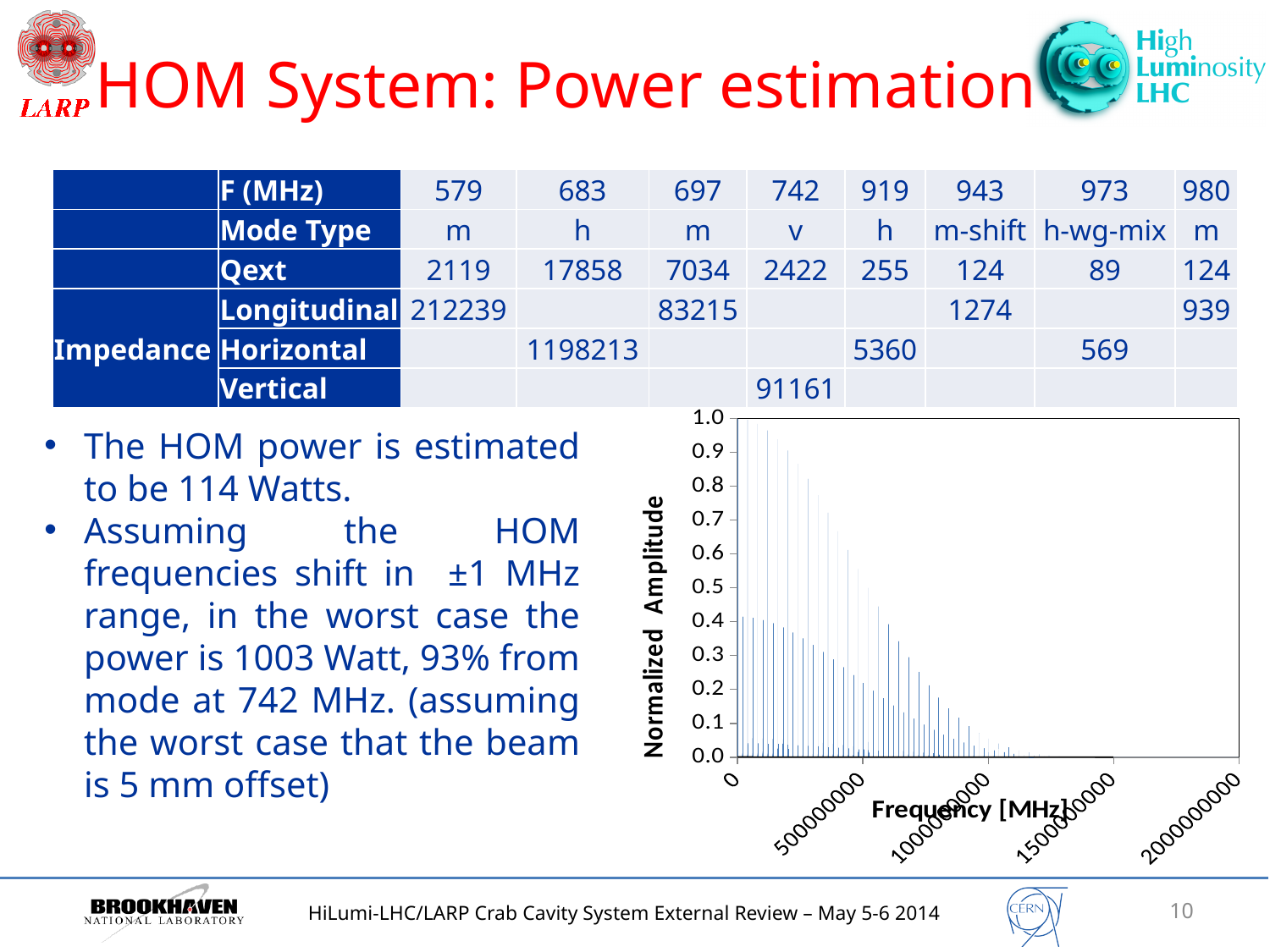
Is the tallest peak in the chart greater or less than 0.9 in normalized amplitude? greater Is the normalized amplitude of the peaks near 1500000000 MHz greater or less than 0.1? less What is the label on the horizontal axis of the chart? Frequency [MHz] What is the largest tick value shown on the horizontal axis of the chart? 2000000000 What is the step between consecutive tick labels on the vertical axis of the chart? 0.1 What is the maximum value shown on the vertical axis of the chart? 1.0 Does the chart include a legend? No What is the label on the vertical axis of the chart? Normalized Amplitude Do the peak amplitudes in the chart generally rise or fall as frequency increases? fall How many tick labels are shown on the horizontal axis of the chart? 5